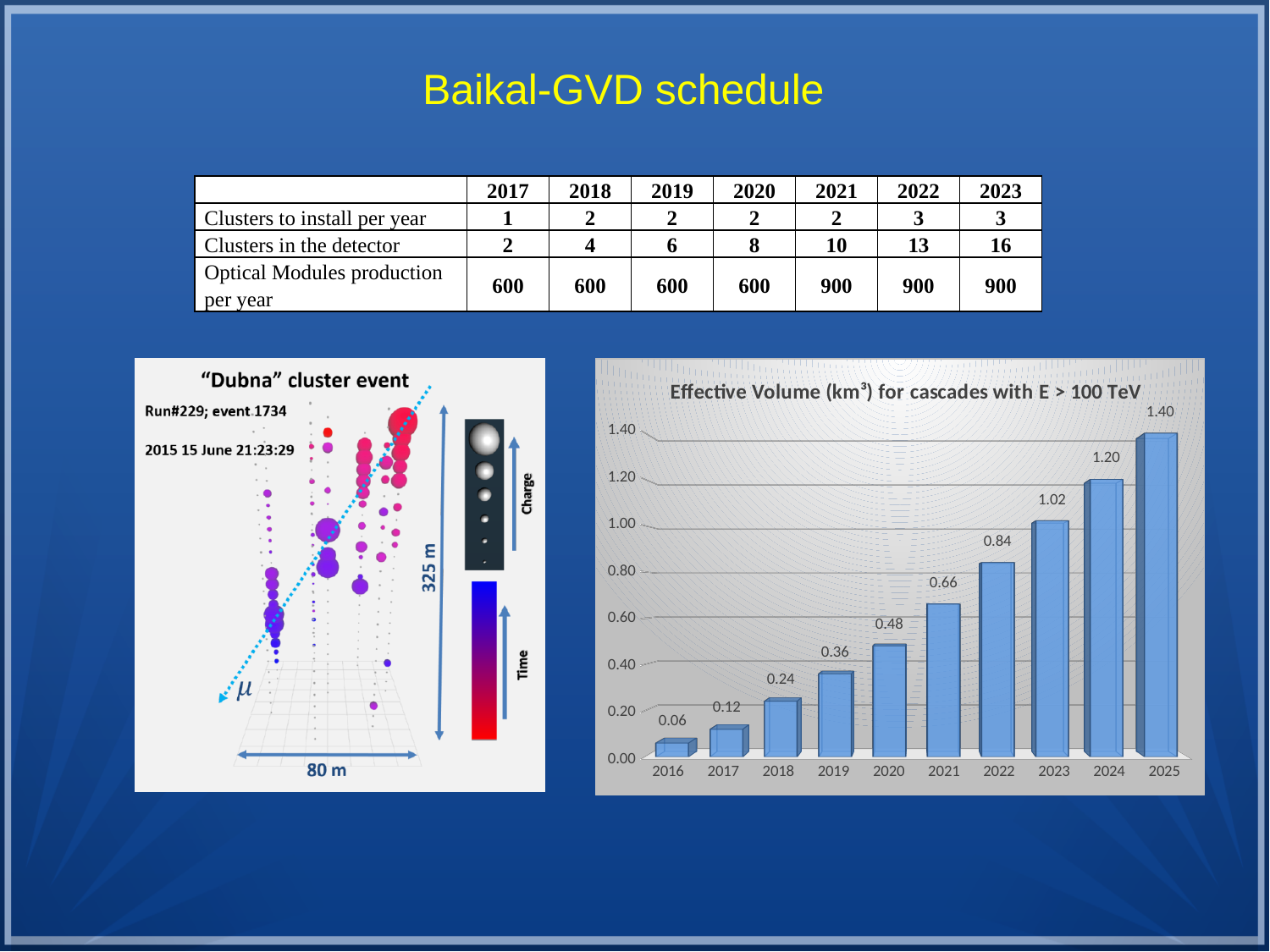
In the Effective Volume chart, is the value for 2024 greater or less than 1.00? greater In the Effective Volume chart, what is the value for 2020? 0.48 In the Effective Volume chart, what is the difference between the values for 2025 and 2021? 0.74 In the Effective Volume chart, what is the value for 2023? 1.02 In the Effective Volume chart, do the values rise or fall from 2016 to 2025? rise In the Effective Volume chart, what is the value for 2016? 0.06 In the Effective Volume chart, which year has the highest value? 2025 In the Effective Volume chart, which is larger, the value for 2019 or the value for 2022? 2022 What is the title of the bar chart on the slide? Effective Volume (km³) for cascades with E > 100 TeV How many years are shown on the x axis of the Effective Volume chart? 10 In the Effective Volume chart, which year has the lowest value? 2016 What kind of chart is the Effective Volume chart? bar chart